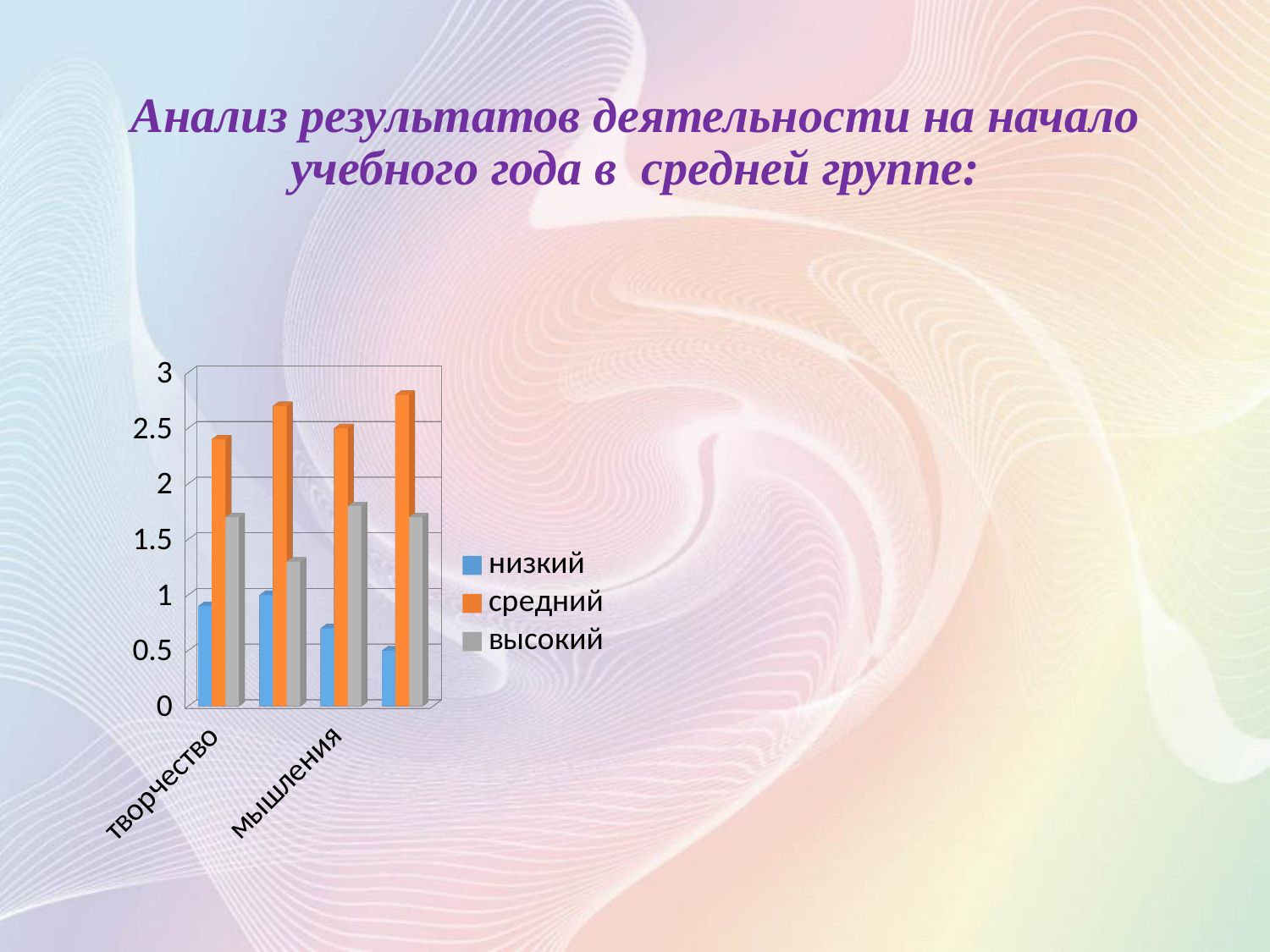
Is the value of низкий for творчество greater or less than 1.5? less What kind of chart is shown on the slide? bar chart How many series does the legend list? 3 Which series has the lowest value for мышления? низкий Is the value of средний for творчество greater or less than 2? greater Is the средний value larger for творчество or for мышления? мышления For мышления, which is larger: низкий or высокий? высокий Is the value of высокий for мышления greater or less than 1.5? greater Which series has the highest value for творчество? средний Which series is represented by the orange bars? средний What is the title of the slide above the chart? Анализ результатов деятельности на начало учебного года в средней группе: